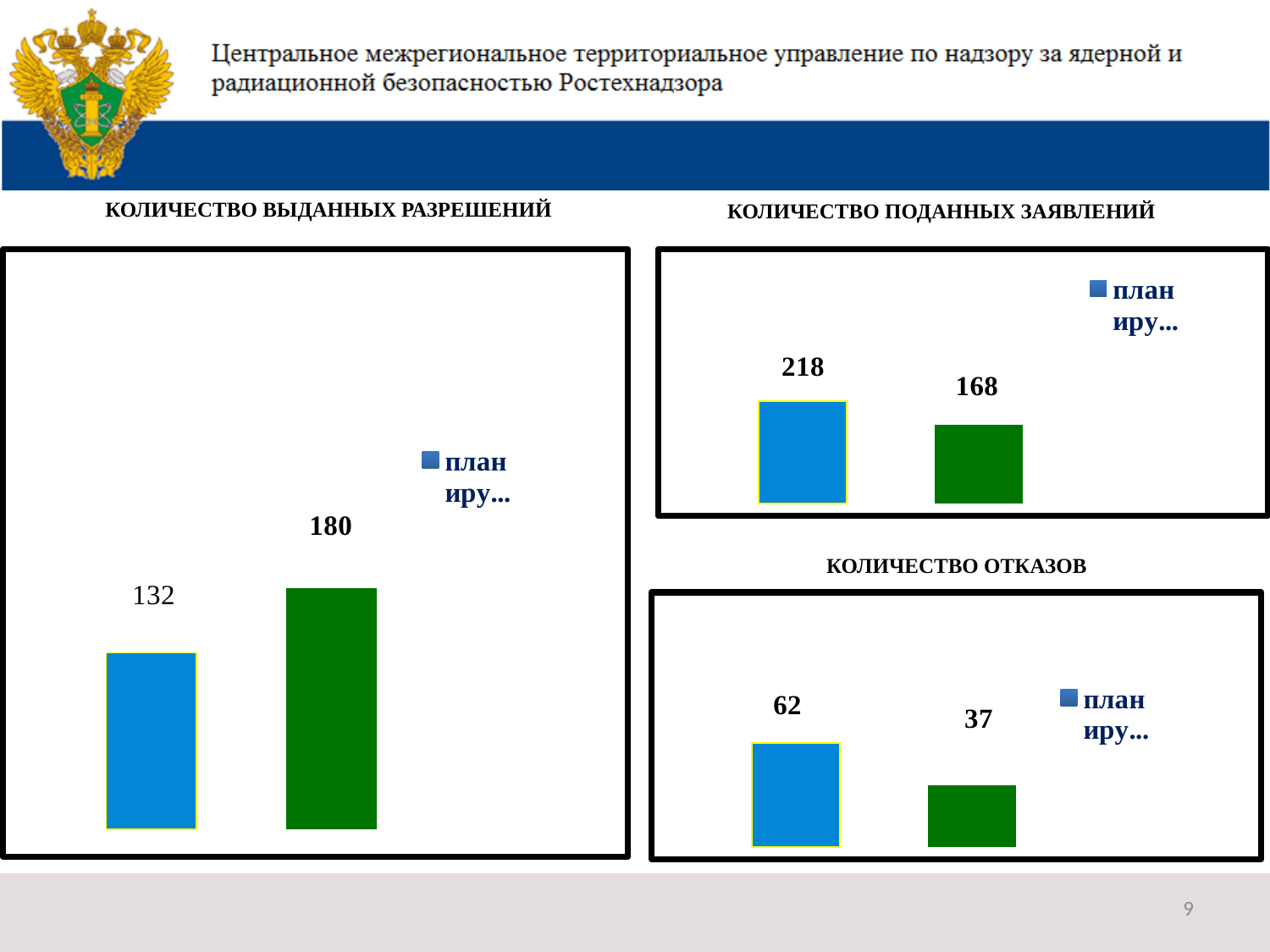
In the chart titled "КОЛИЧЕСТВО ОТКАЗОВ", what value is labelled on the blue bar? 62 In the chart titled "КОЛИЧЕСТВО ВЫДАННЫХ РАЗРЕШЕНИЙ", what is the difference between the green bar and the blue bar? 48 In the chart titled "КОЛИЧЕСТВО ВЫДАННЫХ РАЗРЕШЕНИЙ", what value is labelled on the green bar? 180 In the chart titled "КОЛИЧЕСТВО ОТКАЗОВ", what is the difference between the blue bar and the green bar? 25 In the chart titled "КОЛИЧЕСТВО ВЫДАННЫХ РАЗРЕШЕНИЙ", what value is labelled on the blue bar? 132 In the chart titled "КОЛИЧЕСТВО ПОДАННЫХ ЗАЯВЛЕНИЙ", what value is labelled on the blue bar? 218 In the chart titled "КОЛИЧЕСТВО ОТКАЗОВ", what value is labelled on the green bar? 37 What type of chart is the one titled "КОЛИЧЕСТВО ПОДАННЫХ ЗАЯВЛЕНИЙ"? bar chart In the chart titled "КОЛИЧЕСТВО ПОДАННЫХ ЗАЯВЛЕНИЙ", what value is labelled on the green bar? 168 In the chart titled "КОЛИЧЕСТВО ПОДАННЫХ ЗАЯВЛЕНИЙ", what is the difference between the blue bar and the green bar? 50 In the chart titled "КОЛИЧЕСТВО ВЫДАННЫХ РАЗРЕШЕНИЙ", which bar is taller, the blue one or the green one? the green one How many bars are plotted in the chart titled "КОЛИЧЕСТВО ОТКАЗОВ"? 2